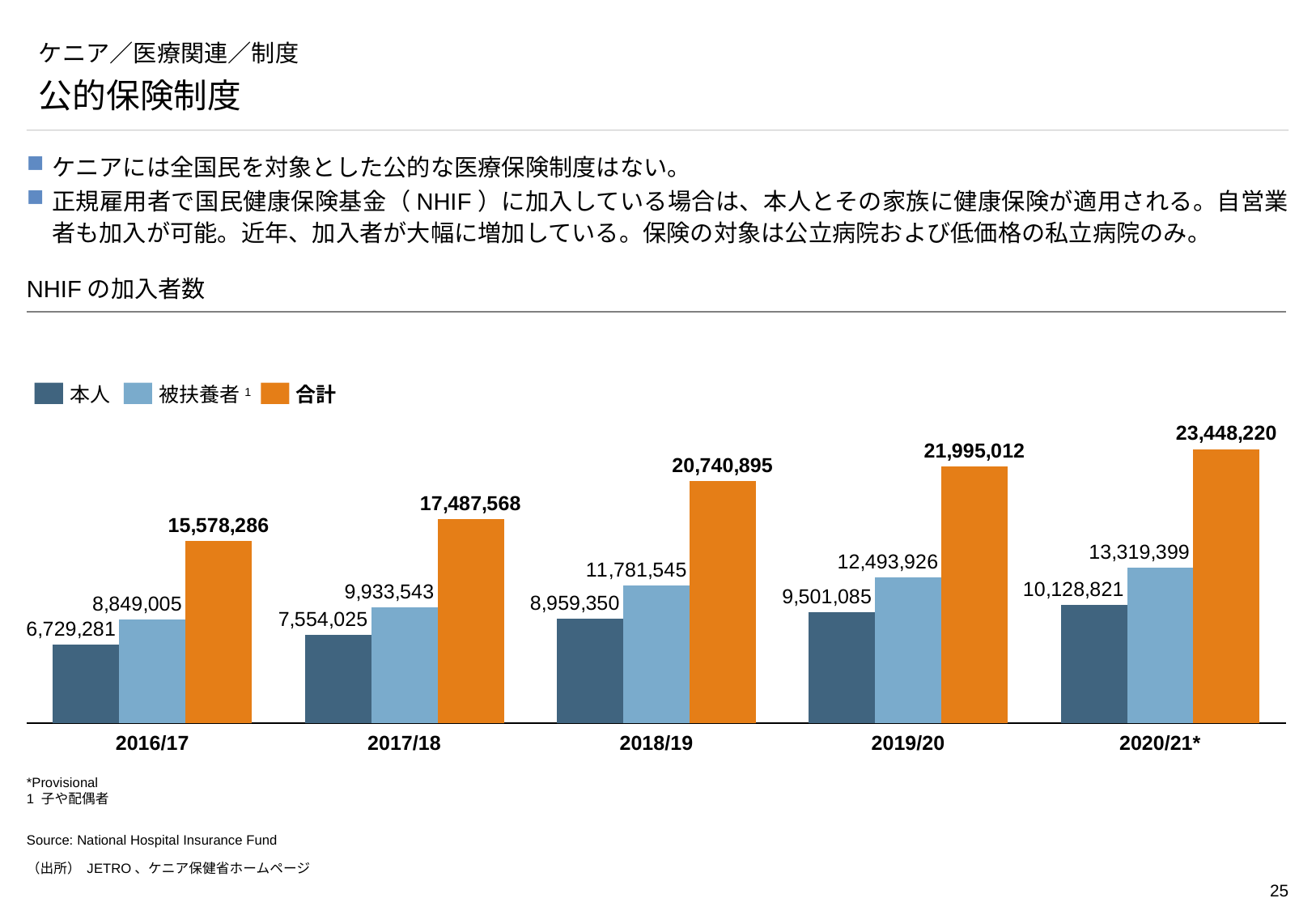
Which is larger in 2017/18, 本人 or 被扶養者? 被扶養者 How many series does the legend list? 3 What is the value of 合計 for 2020/21*? 23,448,220 What is the difference between 合計 in 2020/21* and 合計 in 2016/17? 7,869,934 What is the value of 被扶養者 for 2018/19? 11,781,545 How many fiscal years are shown on the x axis? 5 What is the value of 本人 for 2016/17? 6,729,281 What is the difference between 被扶養者 and 本人 in 2019/20? 2,992,841 Does 合計 rise or fall from 2016/17 to 2020/21*? Rise What type of chart is shown on the slide? Bar chart In which fiscal year is 合計 the highest? 2020/21* In which fiscal year is 本人 the lowest? 2016/17